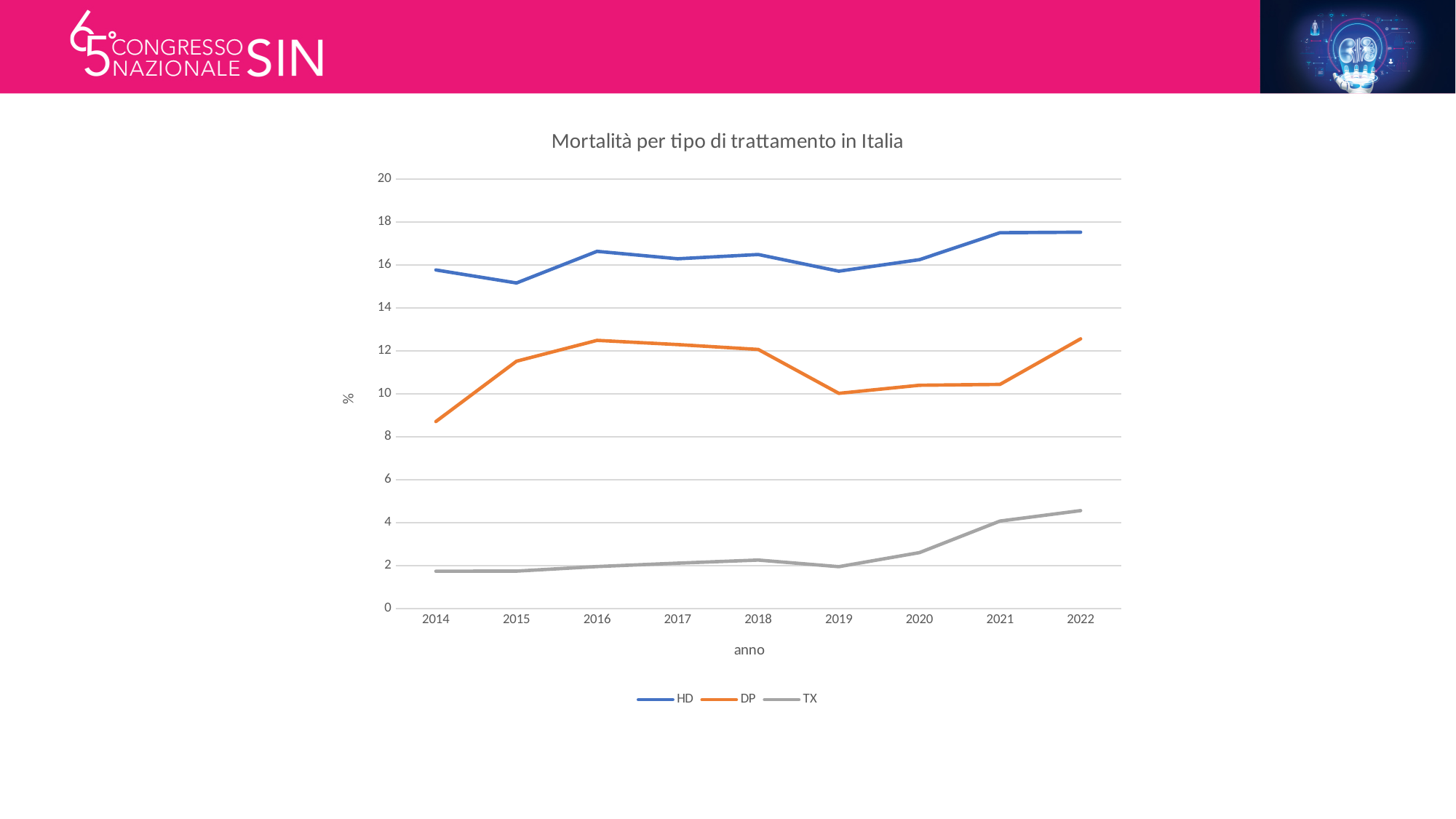
Is the value for HD in 2021 greater or less than 18? less How many years are plotted along the x axis? 9 What kind of chart is shown on the slide? line chart Is the value for HD in 2014 greater or less than 14? greater Which series is shown in orange in the legend? DP In which year is the TX series at its highest? 2022 In which year is the DP series at its lowest? 2014 Which series has the larger value in 2022, HD or DP? HD How many series does the legend list? 3 Is the value for DP in 2014 greater or less than 10? less What is the title of the chart? Mortalità per tipo di trattamento in Italia